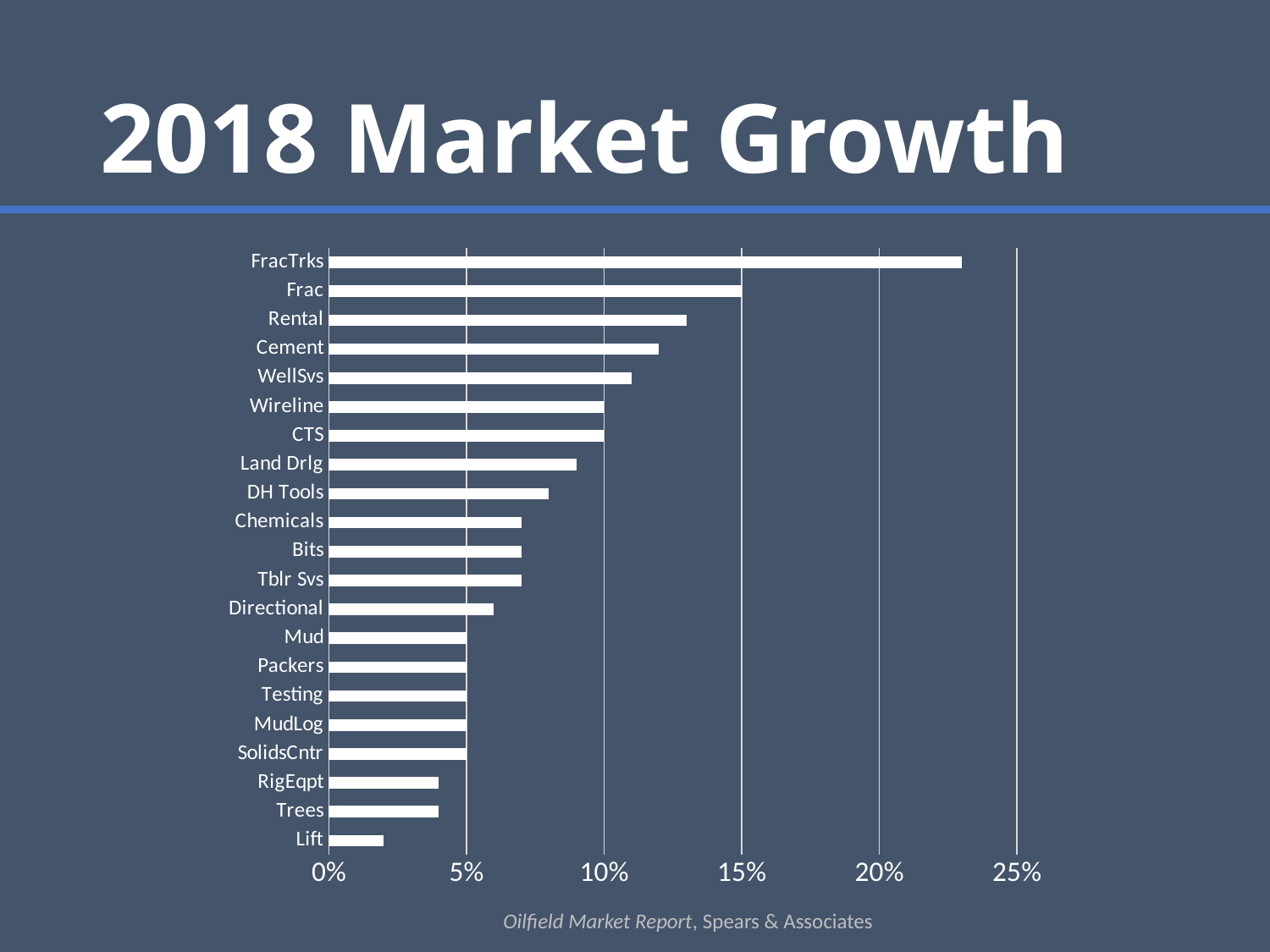
What is the market growth value for Wireline? 10% Is the value for Lift greater or less than 5%? less Which category has the highest 2018 market growth? FracTrks Which has the larger value, Land Drlg or DH Tools? Land Drlg What kind of chart is shown on the slide? bar chart What is the title of the slide containing the chart? 2018 Market Growth Is the value for FracTrks greater or less than 20%? greater How many categories are plotted in the chart? 21 What is the market growth value for Mud? 5% Which category has the lowest 2018 market growth? Lift What is the market growth value for Frac? 15% Is the value for Rental greater or less than 15%? less